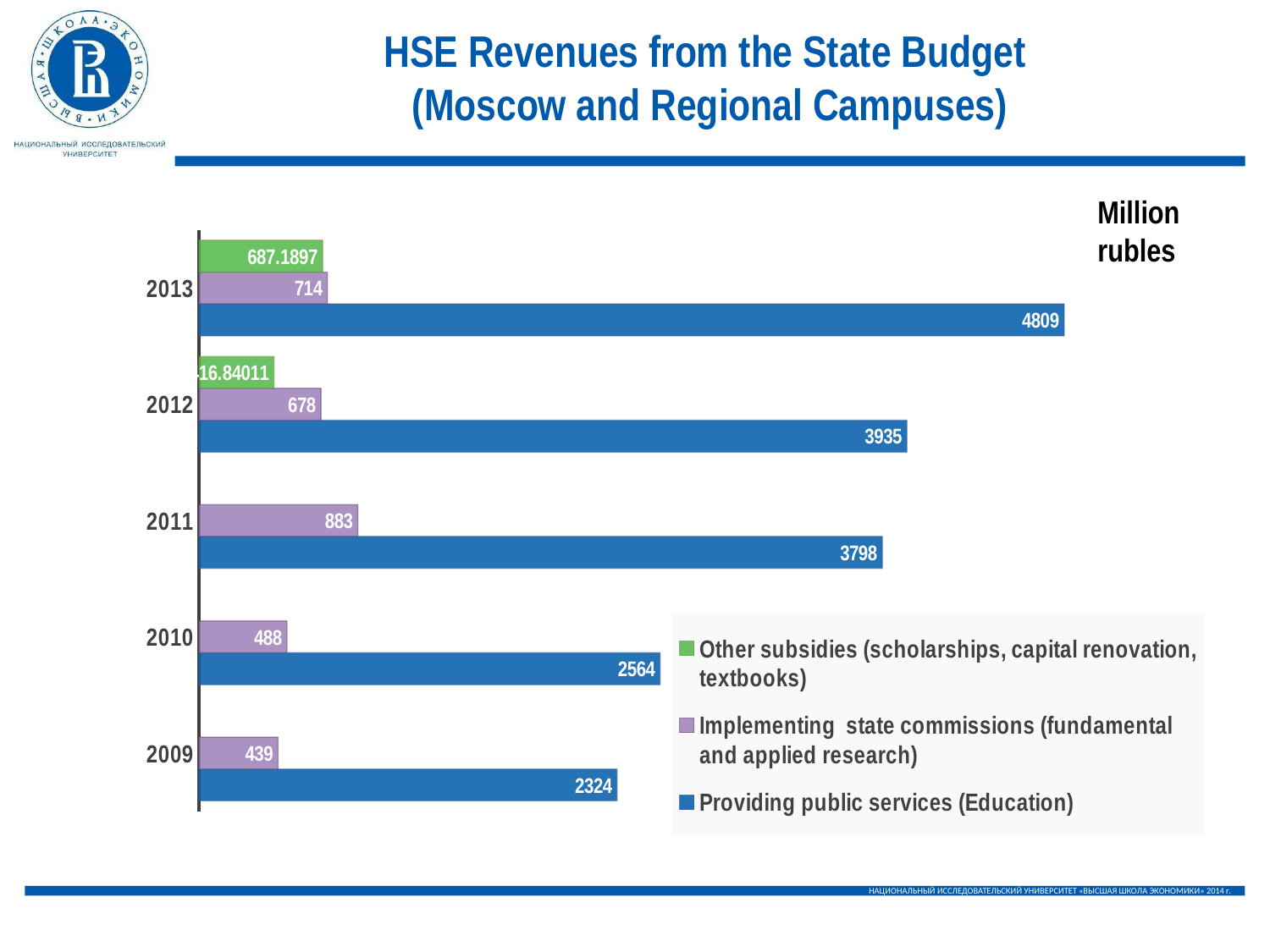
How many years are shown on the chart? 5 In which year was the value for Providing public services (Education) the highest? 2013 Does the value for Providing public services (Education) rise or fall from 2009 to 2013? rise How many series does the legend list? 3 What was the value for Implementing state commissions (fundamental and applied research) in 2011? 883 What is the difference between the Providing public services (Education) values for 2013 and 2012? 874 What was the value for Providing public services (Education) in 2009? 2324 What type of chart is shown on the slide? bar chart What was the value for Other subsidies (scholarships, capital renovation, textbooks) in 2013? 687.1897 What was the value for Providing public services (Education) in 2013? 4809 In which year was the value for Implementing state commissions (fundamental and applied research) the lowest? 2009 Which is larger: the Implementing state commissions value for 2011 or for 2012? 2011